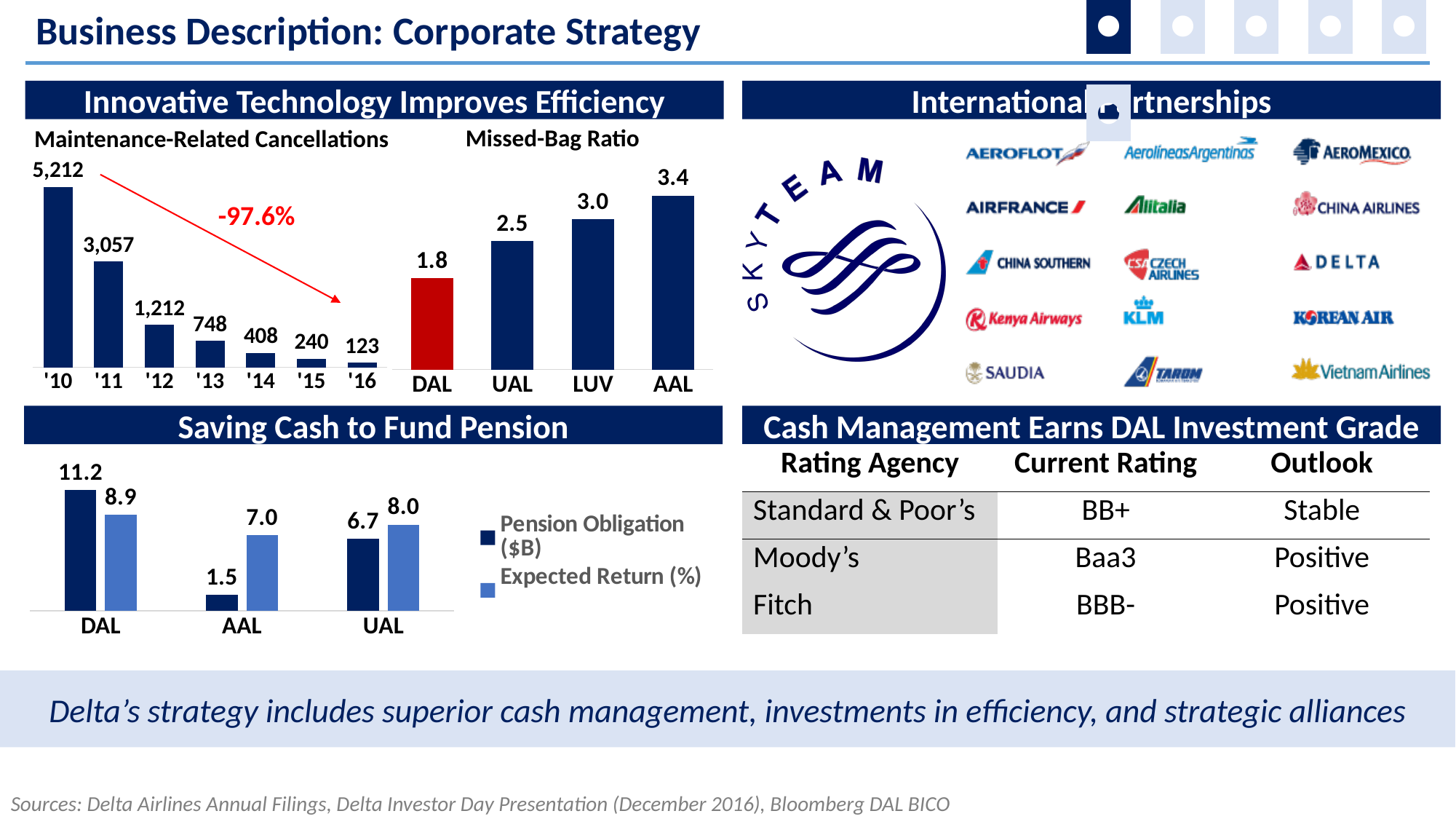
In the Missed-Bag Ratio chart, what is the value for DAL? 1.8 In the Saving Cash to Fund Pension chart, which is larger for UAL: Pension Obligation ($B) or Expected Return (%)? Expected Return (%) In the Saving Cash to Fund Pension chart, how many series does the legend list? 2 In the Maintenance-Related Cancellations chart, how many years are shown? 7 In the Maintenance-Related Cancellations chart, which year has the lowest value? '16 In the Missed-Bag Ratio chart, which airline has the highest value? AAL In the Saving Cash to Fund Pension chart, what is the Pension Obligation ($B) for AAL? 1.5 In the Maintenance-Related Cancellations chart, what is the difference between '12 and '13? 464 In the Maintenance-Related Cancellations chart, do the values rise or fall from '10 to '16? fall In the Missed-Bag Ratio chart, what is the difference between AAL and DAL? 1.6 In the Maintenance-Related Cancellations chart, what is the value for '10? 5,212 In the Maintenance-Related Cancellations chart, what is the value for '16? 123